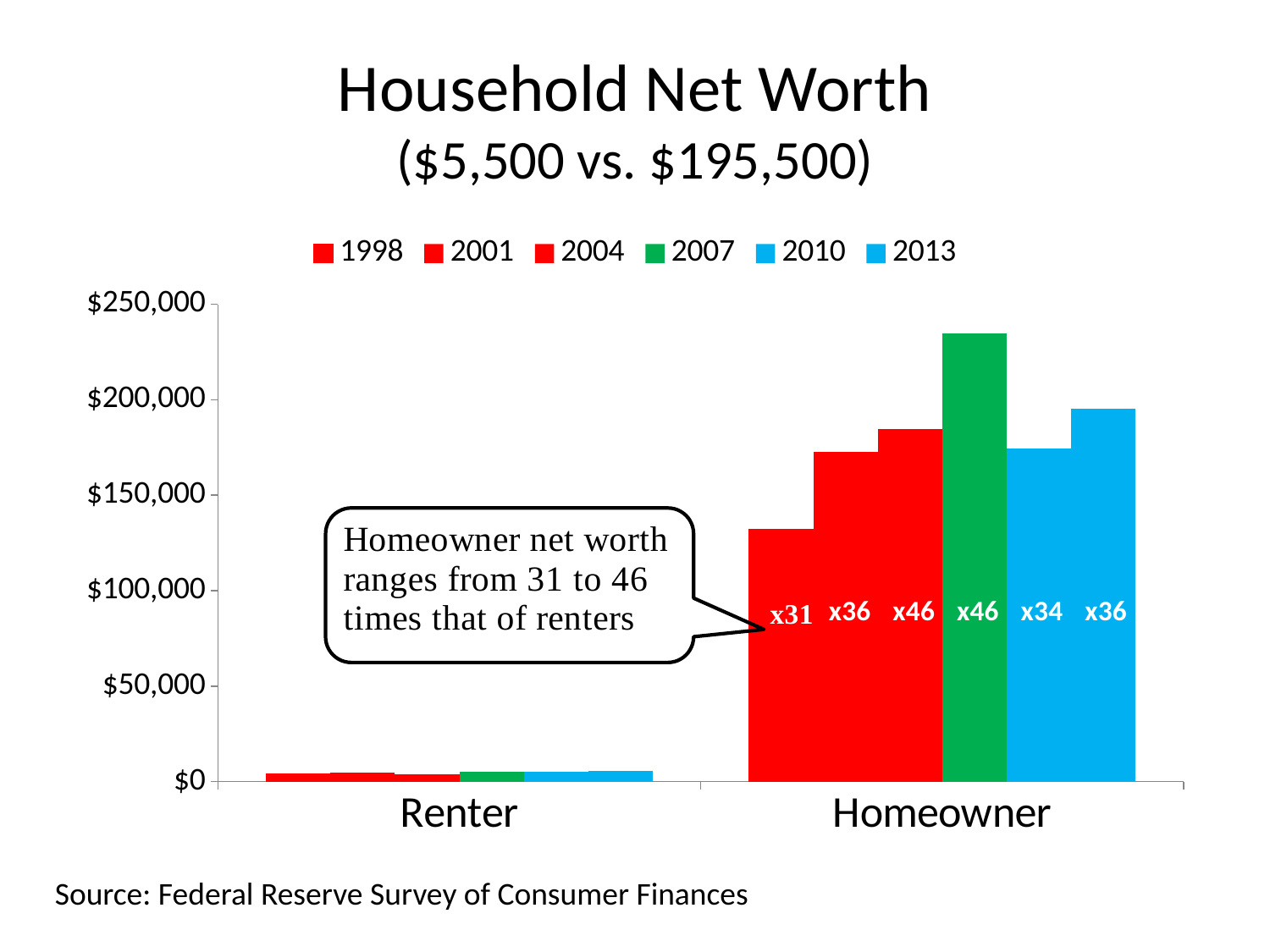
Is the Homeowner value for 1998 greater or less than $150,000? less How many series does the legend list? 6 Which is larger, the Homeowner value for 2007 or for 2013? 2007 What colour represents the 2007 series in the legend? green Which year has the highest net worth for Homeowner? 2007 What kind of chart is shown on the slide? bar chart What multiplier label is printed on the 2007 Homeowner bar? x46 Which year has the lowest net worth for Homeowner? 1998 How many categories are shown on the x axis? 2 What multiplier label is printed on the 1998 Homeowner bar? x31 Is the Homeowner value for 2007 greater or less than $200,000? greater Is the Renter value for 2013 greater or less than $50,000? less